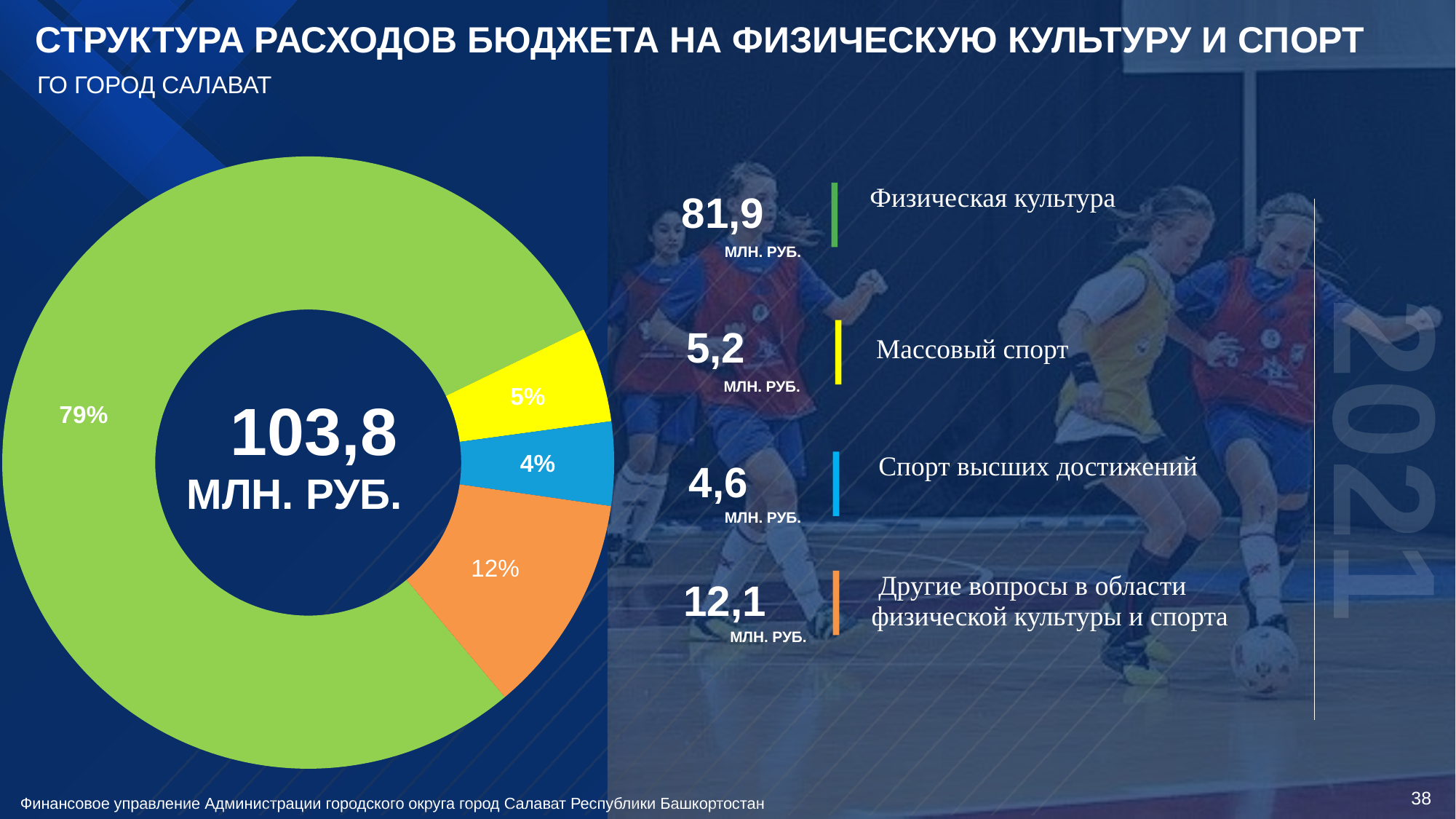
What share of the chart does Спорт высших достижений take? 4% What kind of chart is shown on the slide? Donut (pie) chart What share of the chart does Другие вопросы в области физической культуры и спорта take? 12% Which category has the largest share of the chart? Физическая культура What share of the chart does Массовый спорт take? 5% What is the difference between the values for Массовый спорт and Спорт высших достижений? 0,6 млн. руб. What is the value shown for Физическая культура? 81,9 млн. руб. Which category has the smallest share of the chart? Спорт высших достижений What total value is shown in the centre of the donut chart? 103,8 млн. руб. How many slices does the donut chart have? 4 What is the value shown for Другие вопросы в области физической культуры и спорта? 12,1 млн. руб.